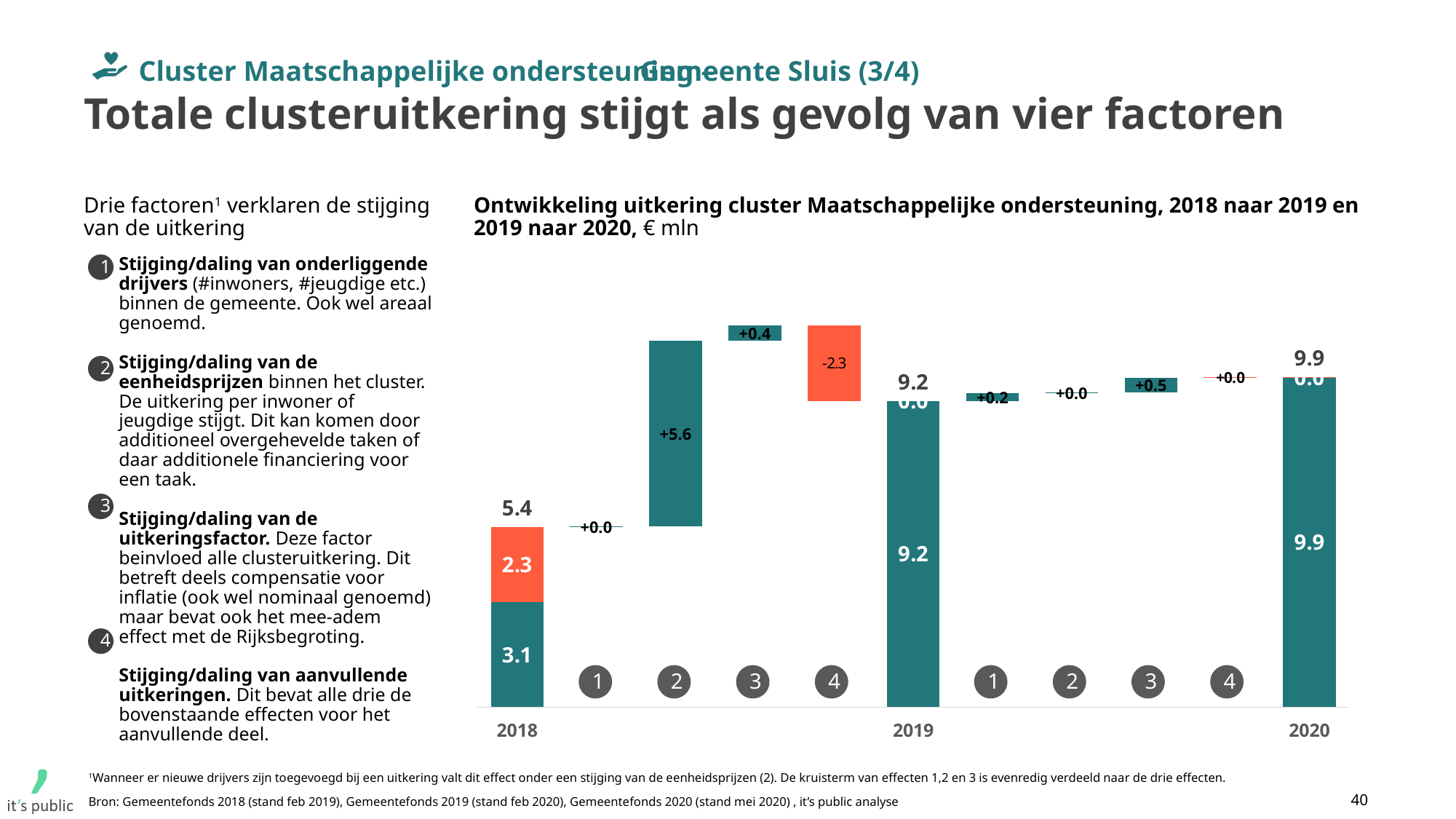
Which of the four factors between 2018 and 2019 has the largest positive value? Factor 2 (+5.6) What is the orange segment of the 2018 bar? 2.3 What is the difference between the 2020 total and the 2018 total? 4.5 In what unit are the values on the chart expressed? € mln What is the value of factor 4 between 2018 and 2019? -2.3 What is the value of factor 2 between 2018 and 2019? +5.6 What is the total uitkering for 2018 shown on the chart? 5.4 What is the teal segment of the 2018 bar? 3.1 What is the value of factor 3 between 2019 and 2020? +0.5 What is the total uitkering for 2019 shown on the chart? 9.2 What is the value of factor 1 between 2019 and 2020? +0.2 What is the total uitkering for 2020 shown on the chart? 9.9